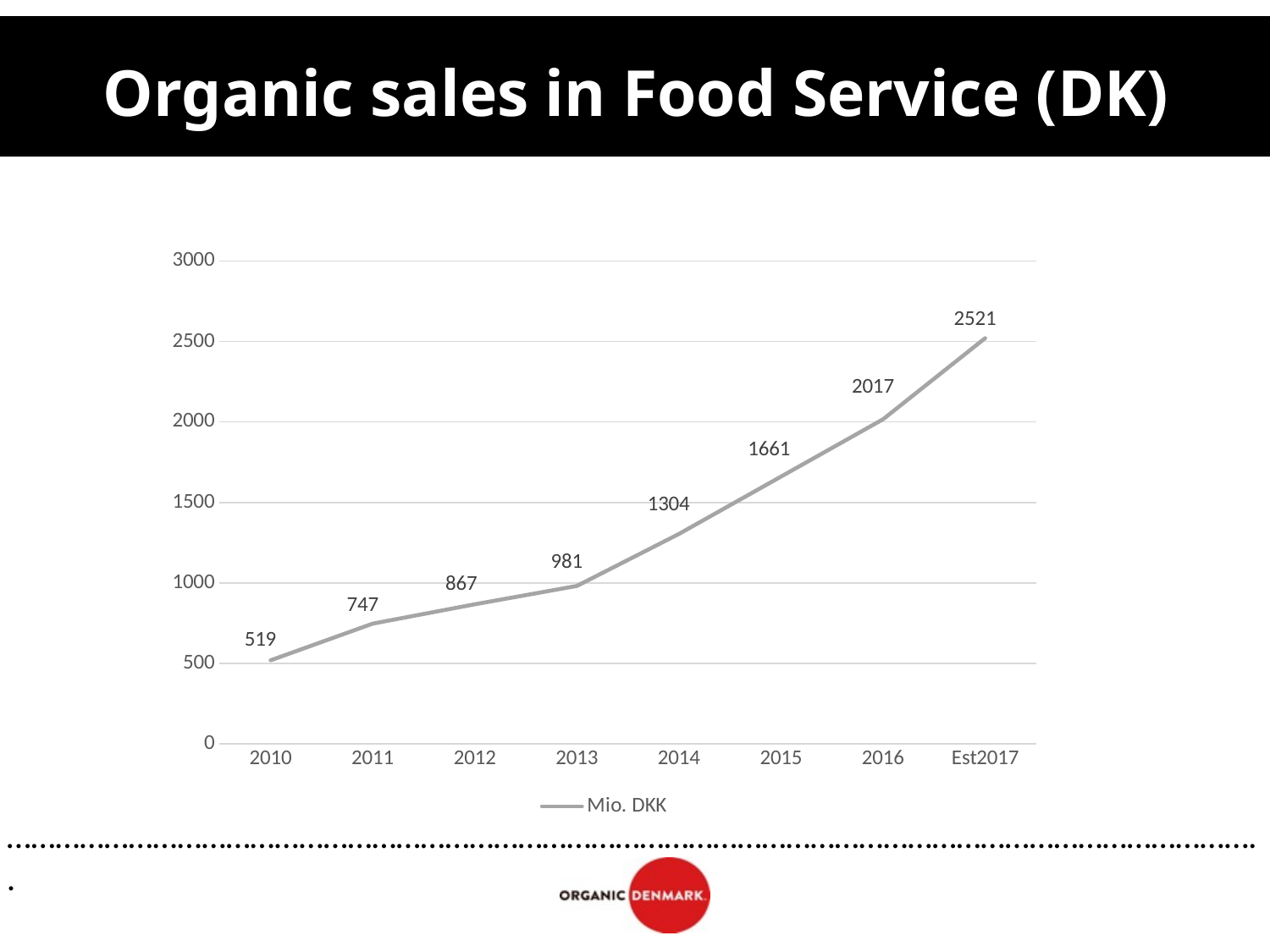
How many series does the legend list? 1 Which is larger, the value for 2012 or the value for 2013? 2013 What is the value for 2014? 1304 Which year has the highest value? Est2017 Which year has the lowest value? 2010 What is the value for Est2017? 2521 What is the value for 2010? 519 What kind of chart is shown? line chart How many data points are plotted on the chart? 8 Is the value for 2015 greater or less than 1500? greater Do the values rise or fall from 2010 to Est2017? rise What is the difference between the values for 2016 and 2015? 356